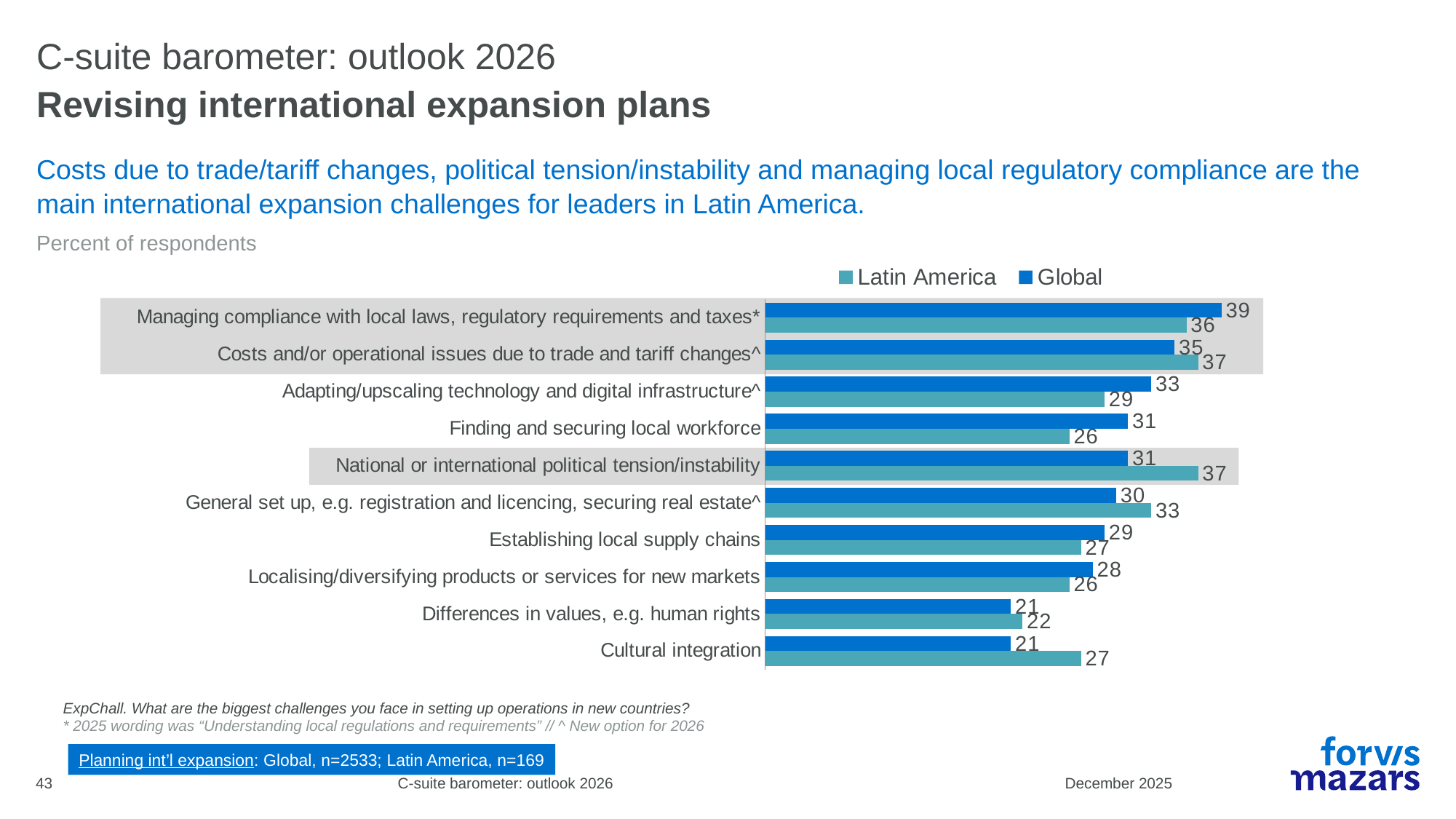
Which category has the lowest Latin America value? Differences in values, e.g. human rights What is the Global value for 'Finding and securing local workforce'? 31 For 'Cultural integration', which is larger: the Latin America value or the Global value? Latin America What is the Global value for 'Managing compliance with local laws, regulatory requirements and taxes*'? 39 How many series does the legend list? 2 What is the difference between the Global and Latin America values for 'Finding and securing local workforce'? 5 What is the Latin America value for 'National or international political tension/instability'? 37 Which category has the highest Global value? Managing compliance with local laws, regulatory requirements and taxes* What is the difference between the Latin America and Global values for 'National or international political tension/instability'? 6 How many categories are shown in the chart? 10 What kind of chart is shown on the slide? Bar chart What is the Latin America value for 'Cultural integration'? 27